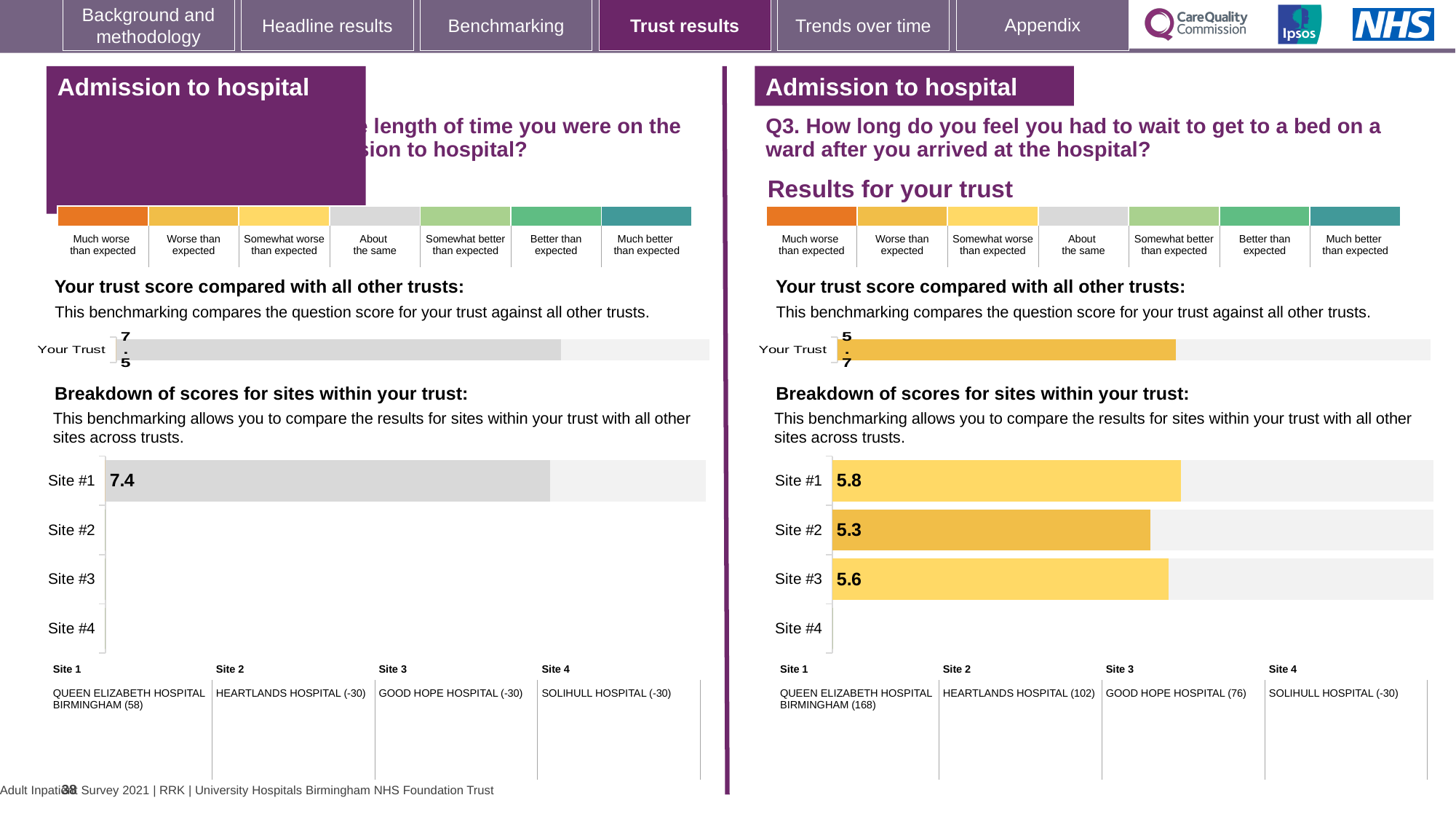
On the right-hand (Q3) site breakdown chart, which has the larger score, Site #2 or Site #3? Site #3 On the left-hand 'Your trust score compared with all other trusts' chart, what is the score for Your Trust? 7.5 On the left-hand site breakdown chart, what is the score for Site #1? 7.4 On the right-hand (Q3) site breakdown chart, what is the difference between the scores for Site #1 and Site #2? 0.5 On the right-hand (Q3) site breakdown chart, what is the score for Site #3? 5.6 On the right-hand (Q3) site breakdown chart, which site has the lowest score? Site #2 On the right-hand (Q3) 'Your trust score compared with all other trusts' chart, what is the score for Your Trust? 5.7 On the right-hand (Q3) site breakdown chart, how many sites have a plotted bar with a score? 3 On the right-hand (Q3) site breakdown chart, which site has the highest score? Site #1 What type of chart is used for the site breakdown on the right-hand (Q3) side of the slide? Bar chart On the right-hand (Q3) site breakdown chart, what is the score for Site #1? 5.8 On the right-hand (Q3) site breakdown chart, what is the score for Site #2? 5.3